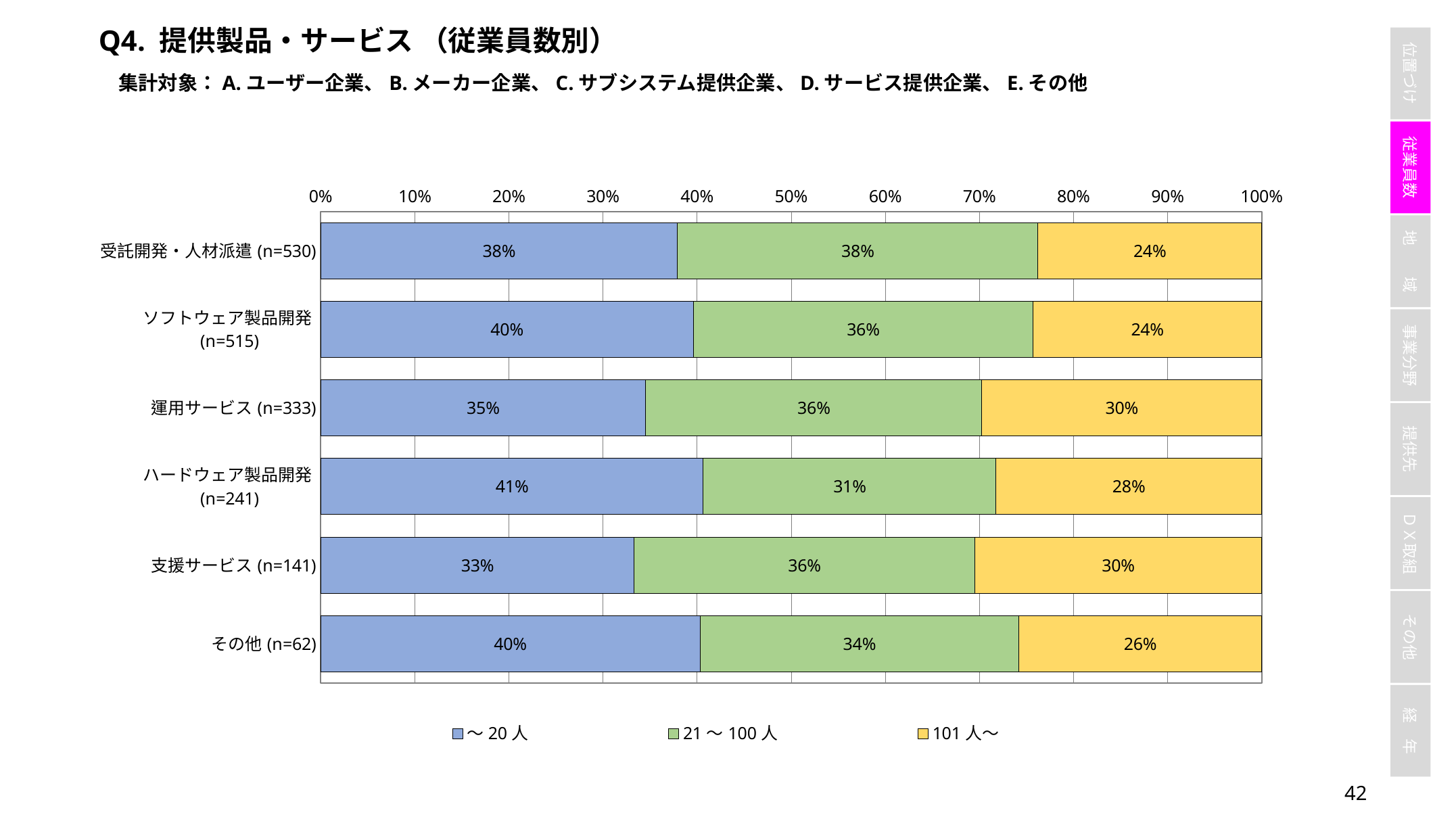
What is the value for 〜20人 in the その他 (n=62) bar? 40% Which category has the lowest value for 〜20人? 支援サービス (n=141) What is the difference between the 101人〜 values for 運用サービス (n=333) and 受託開発・人材派遣 (n=530)? 6% Which is larger: the 21〜100人 value for ソフトウェア製品開発 (n=515) or for ハードウェア製品開発 (n=241)? ソフトウェア製品開発 (n=515) How many series does the legend list? 3 How many categories are shown on the chart? 6 Which category has the highest value for 〜20人? ハードウェア製品開発 (n=241) What is the value for 〜20人 in the 受託開発・人材派遣 (n=530) bar? 38% What is the value for 101人〜 in the 運用サービス (n=333) bar? 30% What kind of chart is shown on the slide? Stacked bar chart Which colour represents the 101人〜 series? Yellow What is the value for 21〜100人 in the ハードウェア製品開発 (n=241) bar? 31%